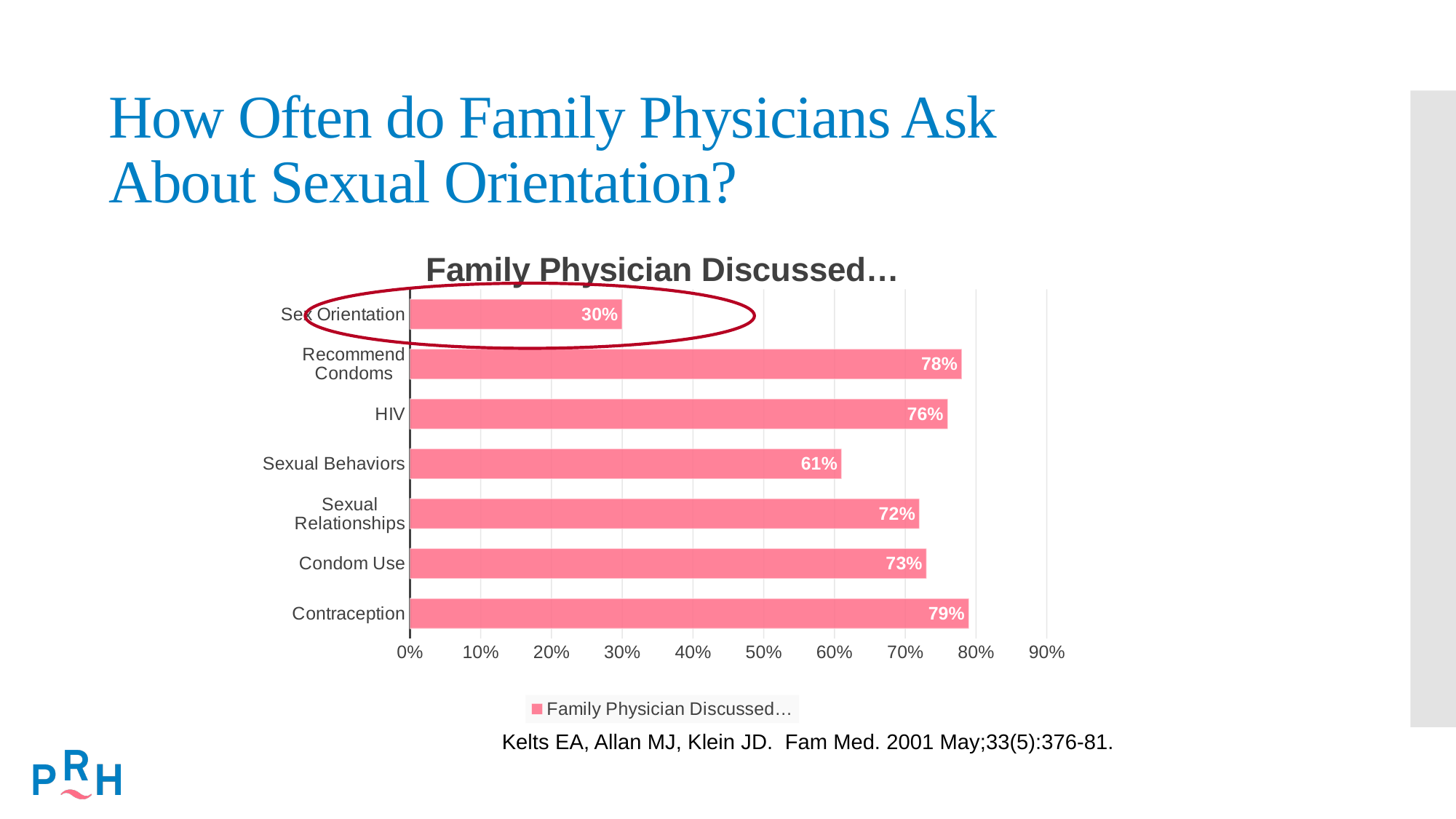
Which category has the lowest value? Sex Orientation What is the title of the chart? Family Physician Discussed… How many series does the legend list? 1 Which category has the highest value? Contraception What is the value for Sexual Behaviors? 61% How many categories are shown in the chart? 7 What is the difference between the values for Recommend Condoms and Sex Orientation? 48% Is the value for Sexual Relationships greater or less than 50%? greater What kind of chart is shown on the slide? Bar chart Which is larger, the value for HIV or the value for Condom Use? HIV What is the value for Contraception? 79% What percentage of family physicians discussed Sex Orientation? 30%